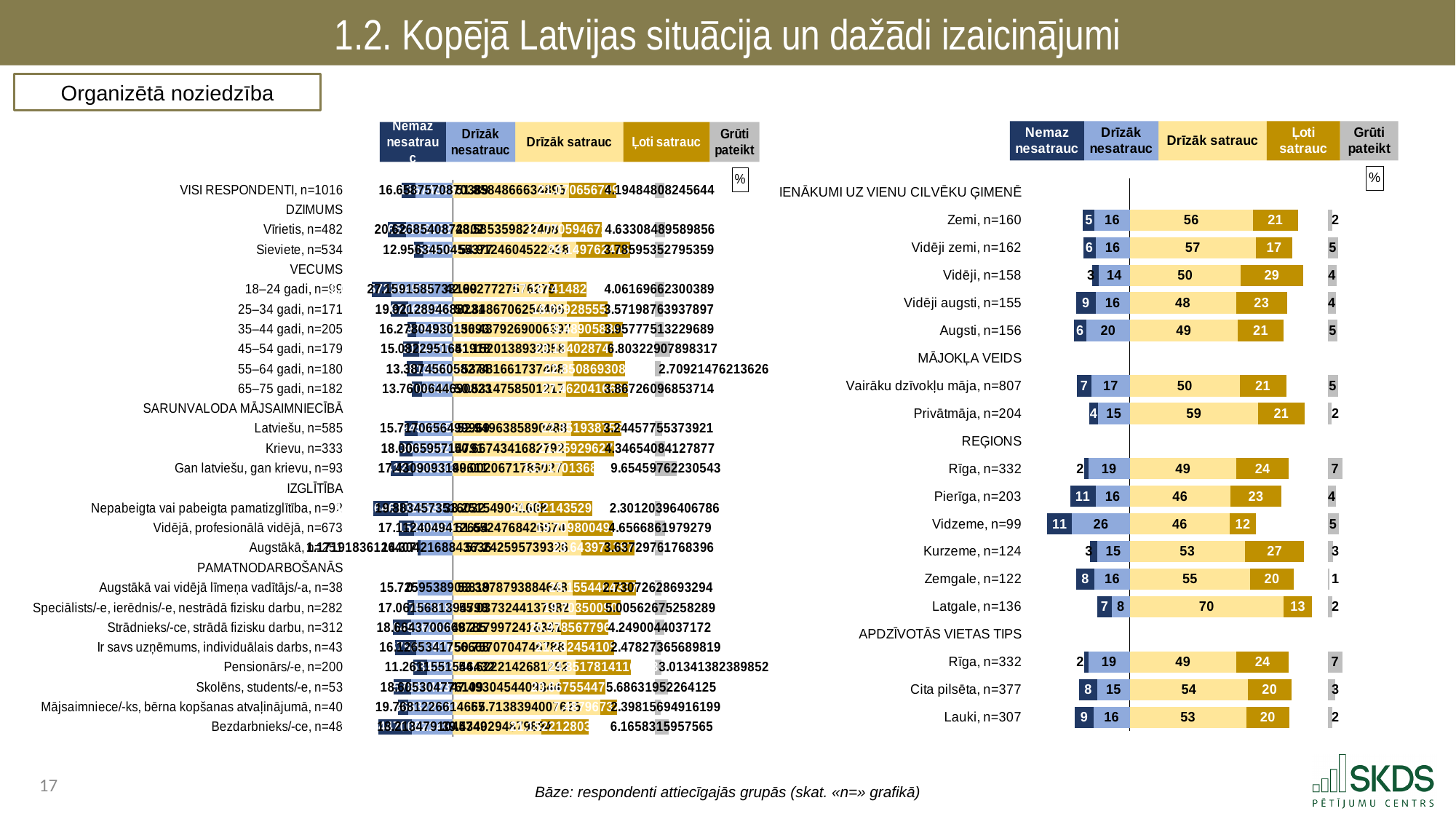
In the right-hand chart, which legend entry is shown in dark blue? Nemaz nesatrauc In the right-hand chart, what is the 'Drīzāk nesatrauc' value for Vidzeme, n=99? 26 In the right-hand chart, which region under REĢIONS has the highest 'Drīzāk satrauc' value? Latgale, n=136 In the right-hand chart, what is the 'Grūti pateikt' value for Rīga, n=332 under REĢIONS? 7 In the right-hand chart, what is the 'Drīzāk satrauc' value for Latgale, n=136? 70 How many series does the legend of the right-hand chart list? 5 In the right-hand chart, what is the total of the stacked bar for Zemi, n=160? 100 In the right-hand chart, what is the 'Ļoti satrauc' value for Vidēji, n=158? 29 In the right-hand chart, which region under REĢIONS has the lowest 'Ļoti satrauc' value? Vidzeme, n=99 In the right-hand chart, what is the difference between the 'Drīzāk satrauc' values for Privātmāja, n=204 and Vairāku dzīvokļu māja, n=807? 9 In the right-hand chart, which has a larger 'Ļoti satrauc' value: Kurzeme, n=124 or Zemgale, n=122? Kurzeme, n=124 What kind of chart is the right-hand chart? Stacked bar chart